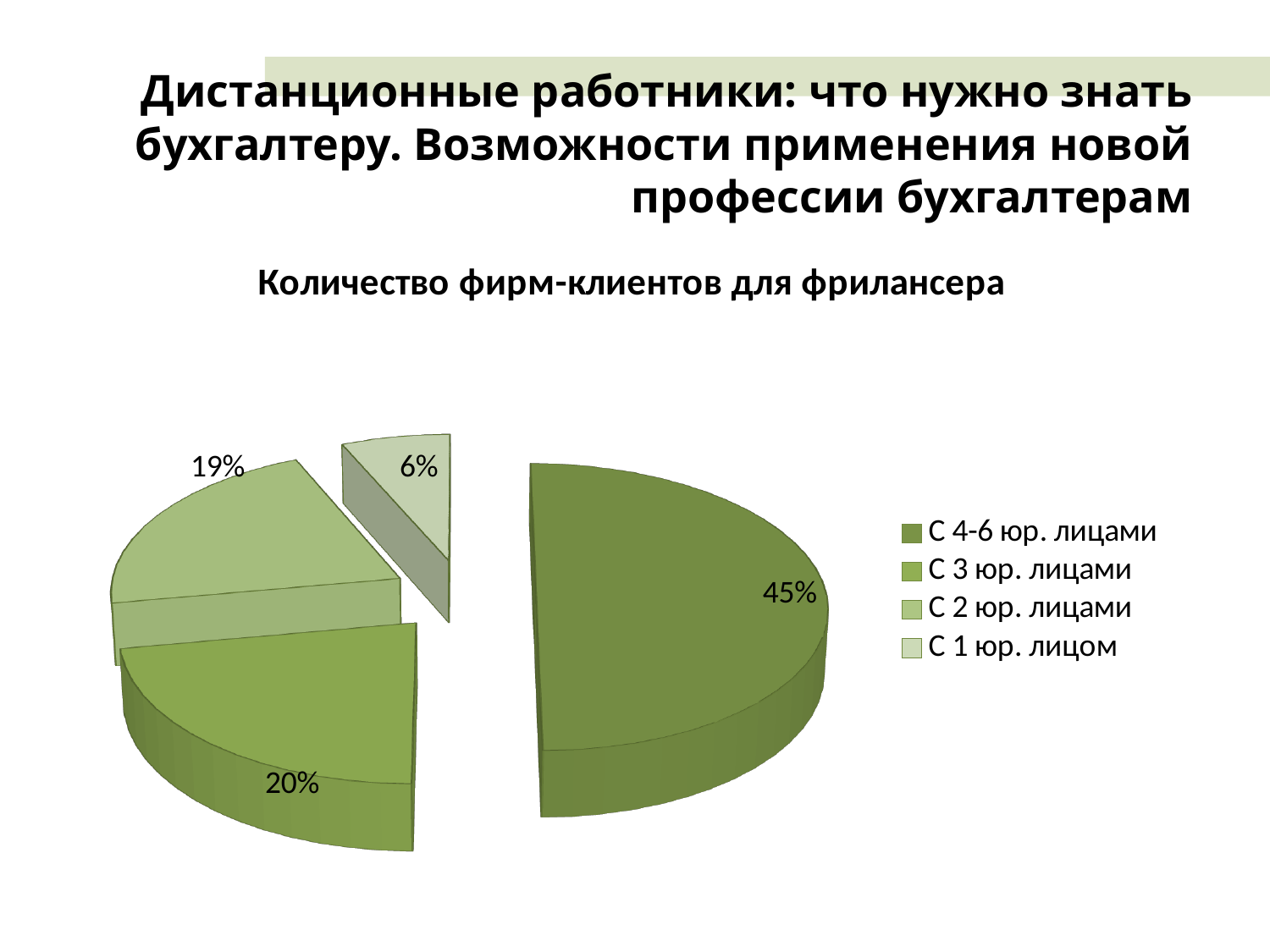
Which category has the largest slice of the pie? С 4-6 юр. лицами What type of chart is shown on the slide? Pie chart What share of the pie is labelled for 'С 1 юр. лицом'? 6% What share of the pie is labelled for 'С 4-6 юр. лицами'? 45% What share of the pie is labelled for 'С 2 юр. лицами'? 19% Which slice is larger: 'С 3 юр. лицами' or 'С 2 юр. лицами'? С 3 юр. лицами What is the combined share of the 'С 2 юр. лицами' and 'С 1 юр. лицом' slices? 25% What is the title of the chart? Количество фирм-клиентов для фрилансера What share of the pie is labelled for 'С 3 юр. лицами'? 20% What is the difference in percentage points between the 'С 4-6 юр. лицами' slice and the 'С 3 юр. лицами' slice? 25% Which category has the smallest slice of the pie? С 1 юр. лицом How many categories does the legend list? 4